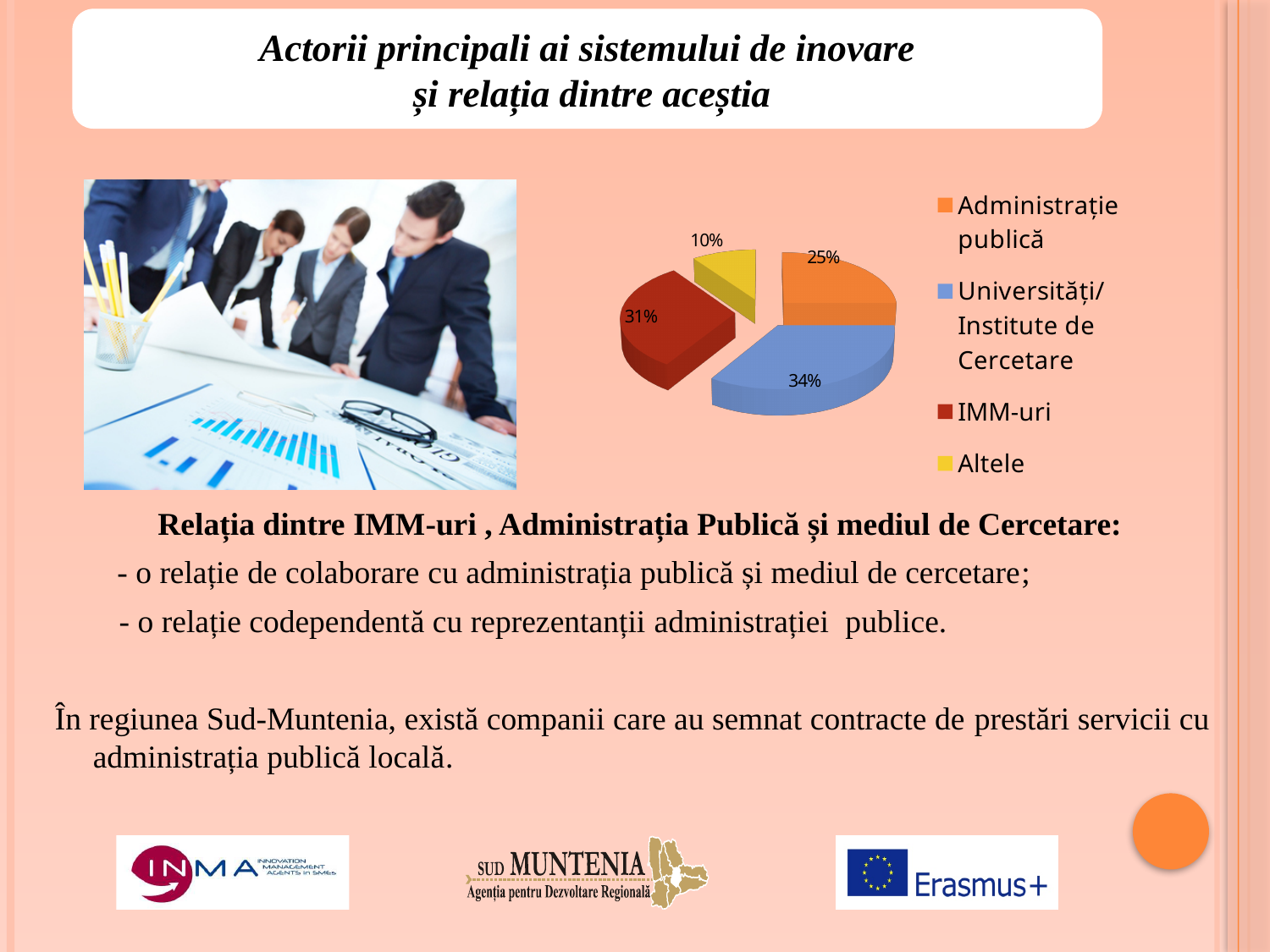
What kind of chart is shown on the slide? pie chart What share of the pie does Altele have? 10% How many entries does the legend list? 4 What colour is the slice for IMM-uri? red What is the difference in percentage points between Universități/Institute de Cercetare and Administrație publică? 9 What share of the pie does IMM-uri have? 31% What share of the pie does Universități/Institute de Cercetare have? 34% What share of the pie does Administrație publică have? 25% Which category has the largest slice of the pie? Universități/Institute de Cercetare Which category has the smallest slice of the pie? Altele Which is larger, the share for IMM-uri or the share for Administrație publică? IMM-uri How many slices does the pie chart have? 4